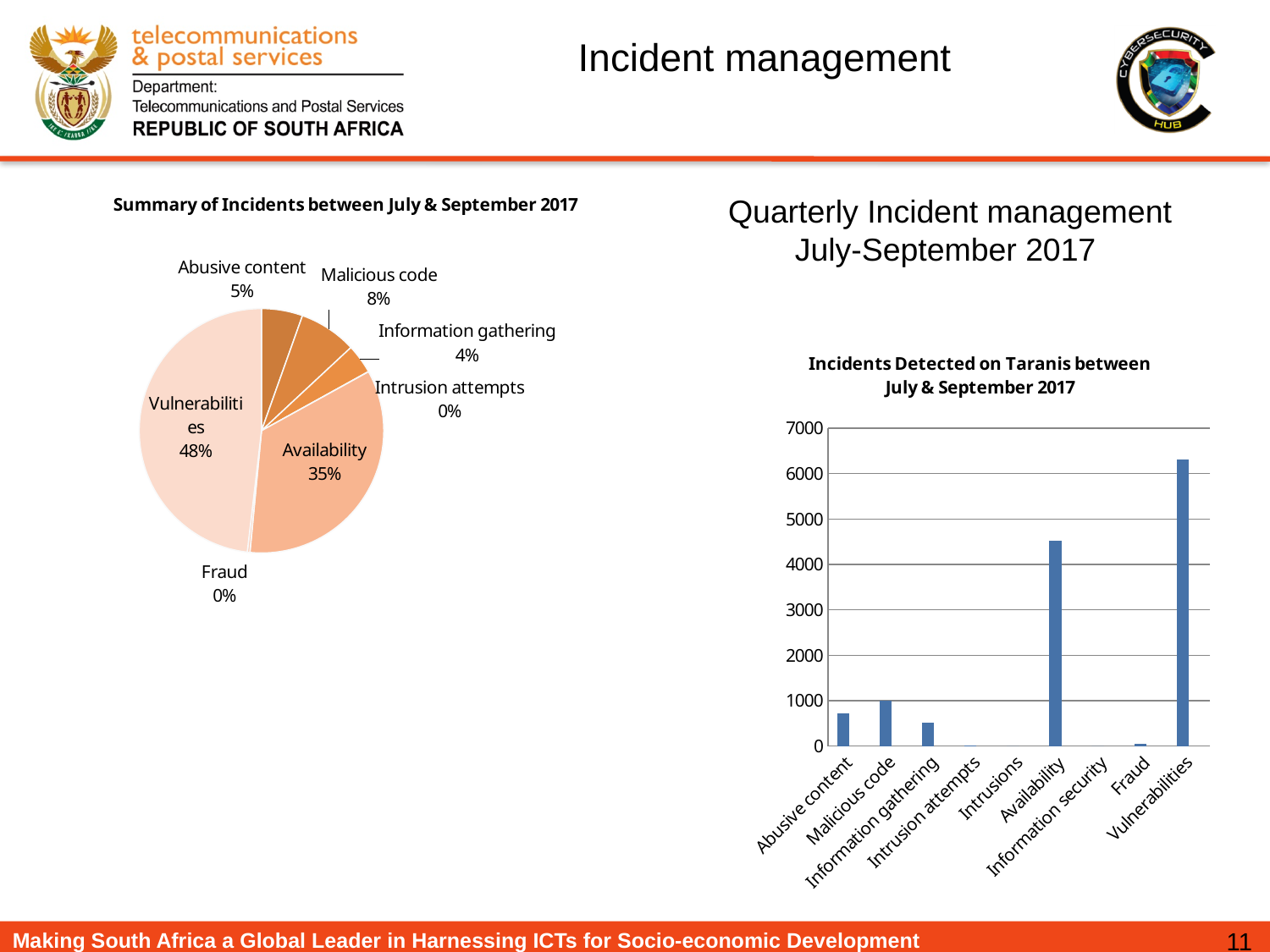
What type of chart is 'Incidents Detected on Taranis between July & September 2017'? Bar chart In the pie chart 'Summary of Incidents between July & September 2017', which is larger: Abusive content or Information gathering? Abusive content In the bar chart 'Incidents Detected on Taranis between July & September 2017', which category has the highest value? Vulnerabilities In the pie chart 'Summary of Incidents between July & September 2017', how many categories are labelled? 7 In the pie chart 'Summary of Incidents between July & September 2017', how many percentage points larger is Vulnerabilities than Availability? 13 In the pie chart 'Summary of Incidents between July & September 2017', what percentage is shown for Malicious code? 8% In the bar chart 'Incidents Detected on Taranis between July & September 2017', how many categories are shown on the x axis? 9 In the bar chart 'Incidents Detected on Taranis between July & September 2017', is the value for Availability greater or less than 5000? less In the pie chart 'Summary of Incidents between July & September 2017', what share do Vulnerabilities account for? 48% In the pie chart 'Summary of Incidents between July & September 2017', which category has the largest share? Vulnerabilities In the bar chart 'Incidents Detected on Taranis between July & September 2017', is the value for Vulnerabilities greater or less than 6000? greater In the pie chart 'Summary of Incidents between July & September 2017', what percentage is shown for Availability? 35%